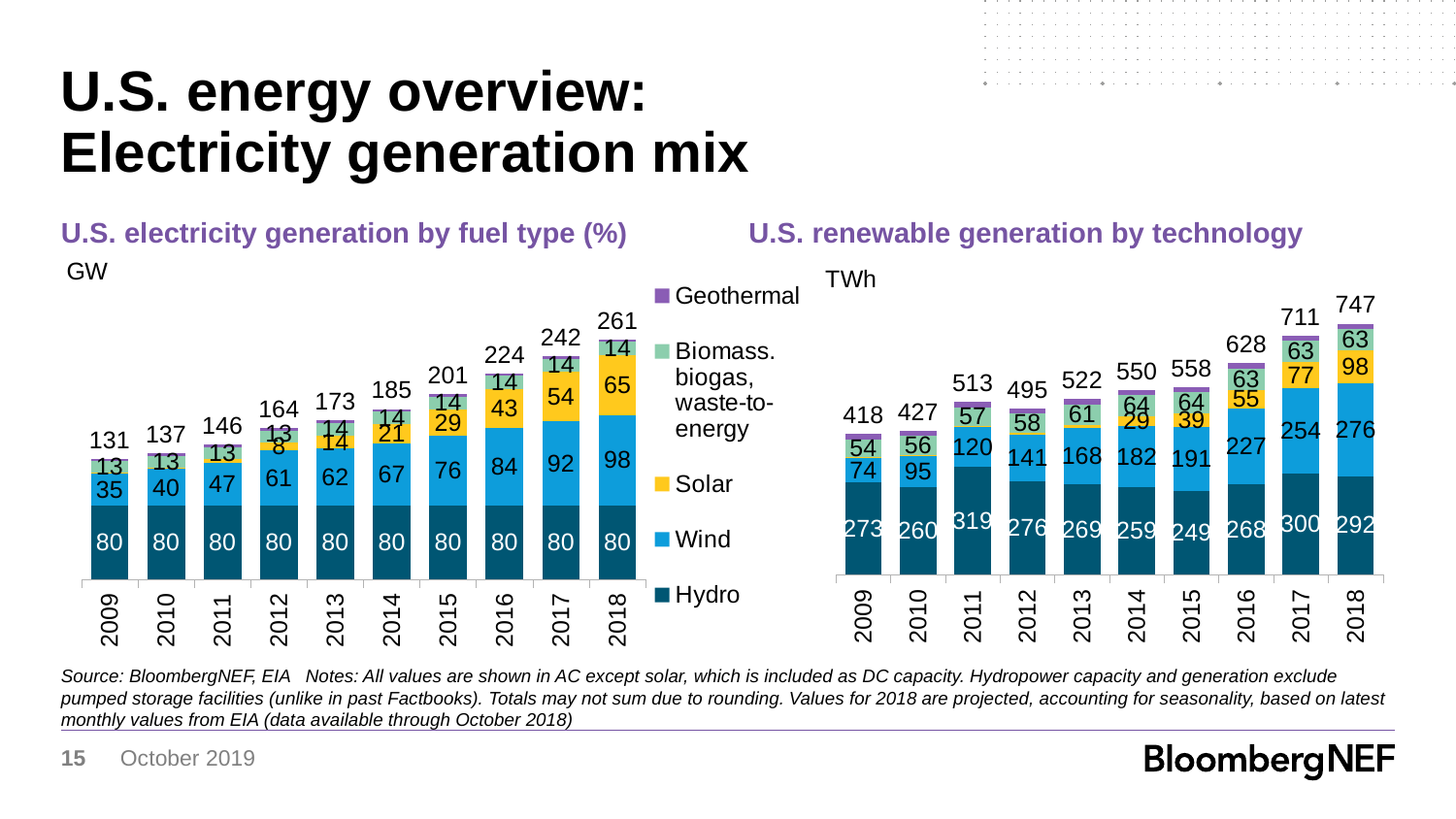
In the 'U.S. electricity generation by fuel type (%)' chart, which year has the lowest total? 2009 In the 'U.S. renewable generation by technology' chart, is the Hydro value larger in 2011 or in 2015? 2011 In the 'U.S. electricity generation by fuel type (%)' chart, what is the total value shown above the 2018 bar? 261 What type of chart is the 'U.S. electricity generation by fuel type (%)' chart? Stacked bar chart How many series does the legend list for the charts on this slide? 5 How many years are shown on the x axis of the 'U.S. renewable generation by technology' chart? 10 In the 'U.S. electricity generation by fuel type (%)' chart, what is the difference between the Wind values for 2018 and 2009? 63 In the 'U.S. renewable generation by technology' chart, which year has the highest total? 2018 In the 'U.S. electricity generation by fuel type (%)' chart, what is the Solar value for 2016? 43 In the 'U.S. renewable generation by technology' chart, what is the Wind value for 2017? 254 In the 'U.S. renewable generation by technology' chart, what is the difference between the 2018 total and the 2017 total? 36 In the 'U.S. renewable generation by technology' chart, what is the Hydro value for 2011? 319